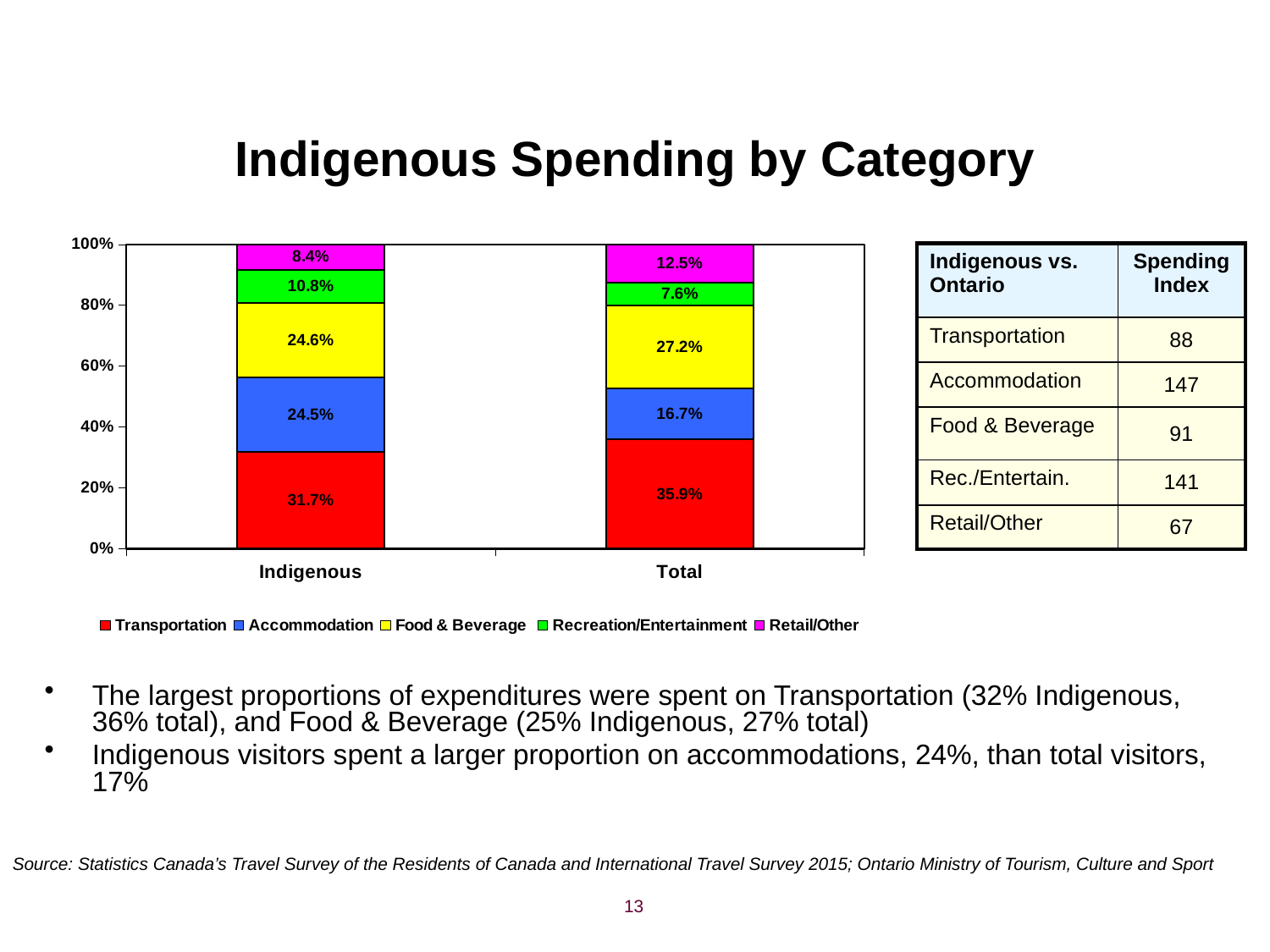
Which spending category has the smallest share in the Total bar? Recreation/Entertainment How many series does the legend list? 5 What is the Retail/Other share for the Indigenous bar? 8.4% What colour represents Food & Beverage in the chart? Yellow Which spending category has the largest share in the Indigenous bar? Transportation Which bar has the larger Retail/Other share, Indigenous or Total? Total How many bars (categories) are shown on the x axis? 2 What percentage of Total spending went to Accommodation? 16.7% How many percentage points higher is the Accommodation share for Indigenous than for Total? 7.8 What is the Food & Beverage share for the Total bar? 27.2% What percentage of Indigenous spending went to Transportation? 31.7% What kind of chart is shown on the slide? Stacked bar chart